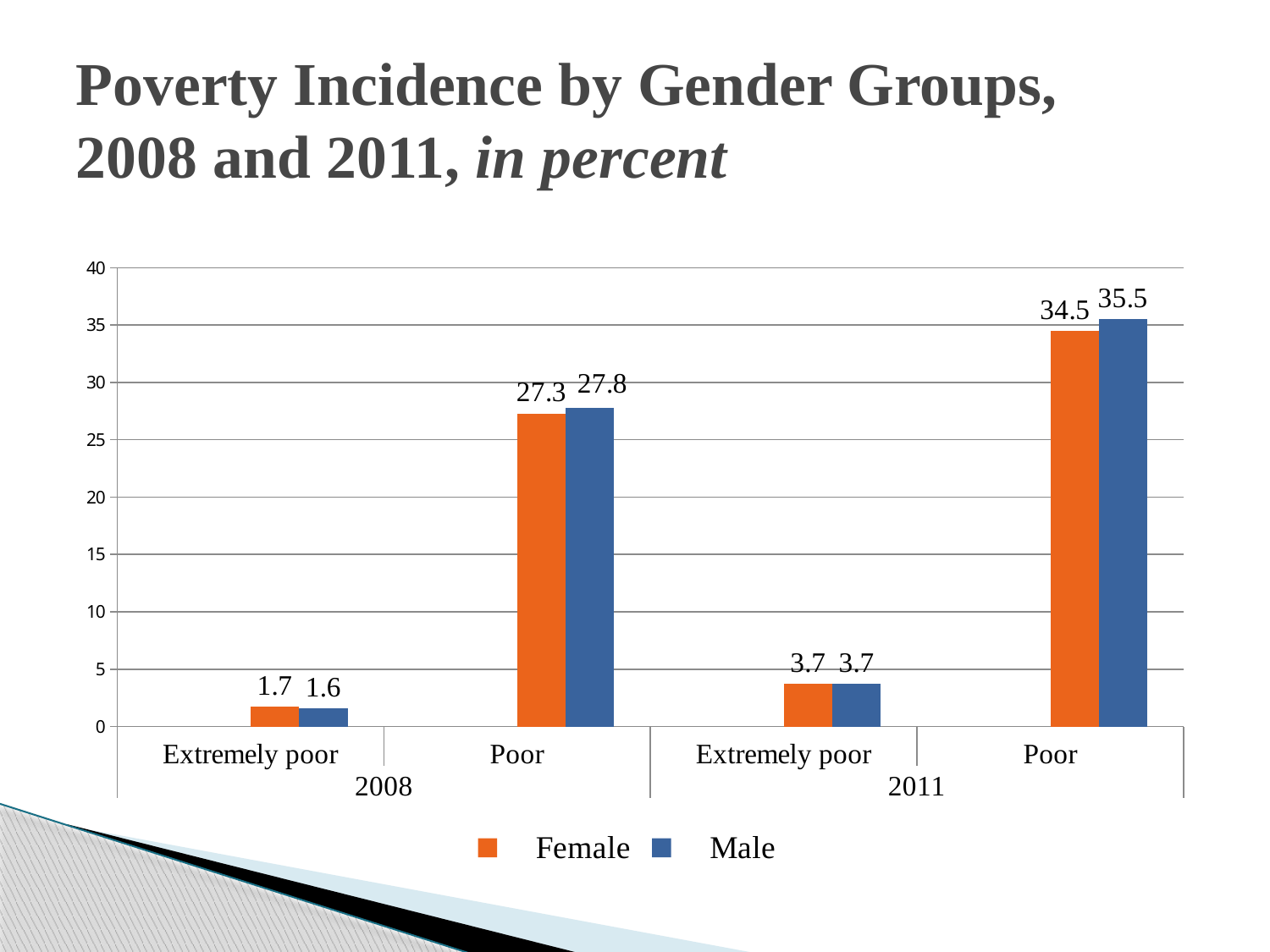
Which category and year has the lowest Male value? Extremely poor, 2008 Which is larger, the Female value for Poor in 2008 or the Male value for Poor in 2008? Male What is the Female value for Extremely poor in 2011? 3.7 What kind of chart is shown on the slide? Bar chart What is the Female value for Extremely poor in 2008? 1.7 Which category and year has the highest Male value? Poor, 2011 What is the Male value for Poor in 2011? 35.5 What colour represents the Female series? Orange What is the difference between the Female values for Poor in 2011 and Poor in 2008? 7.2 What is the difference between the Male and Female values for Poor in 2011? 1.0 What is the Male value for Poor in 2008? 27.8 How many series does the legend list? 2